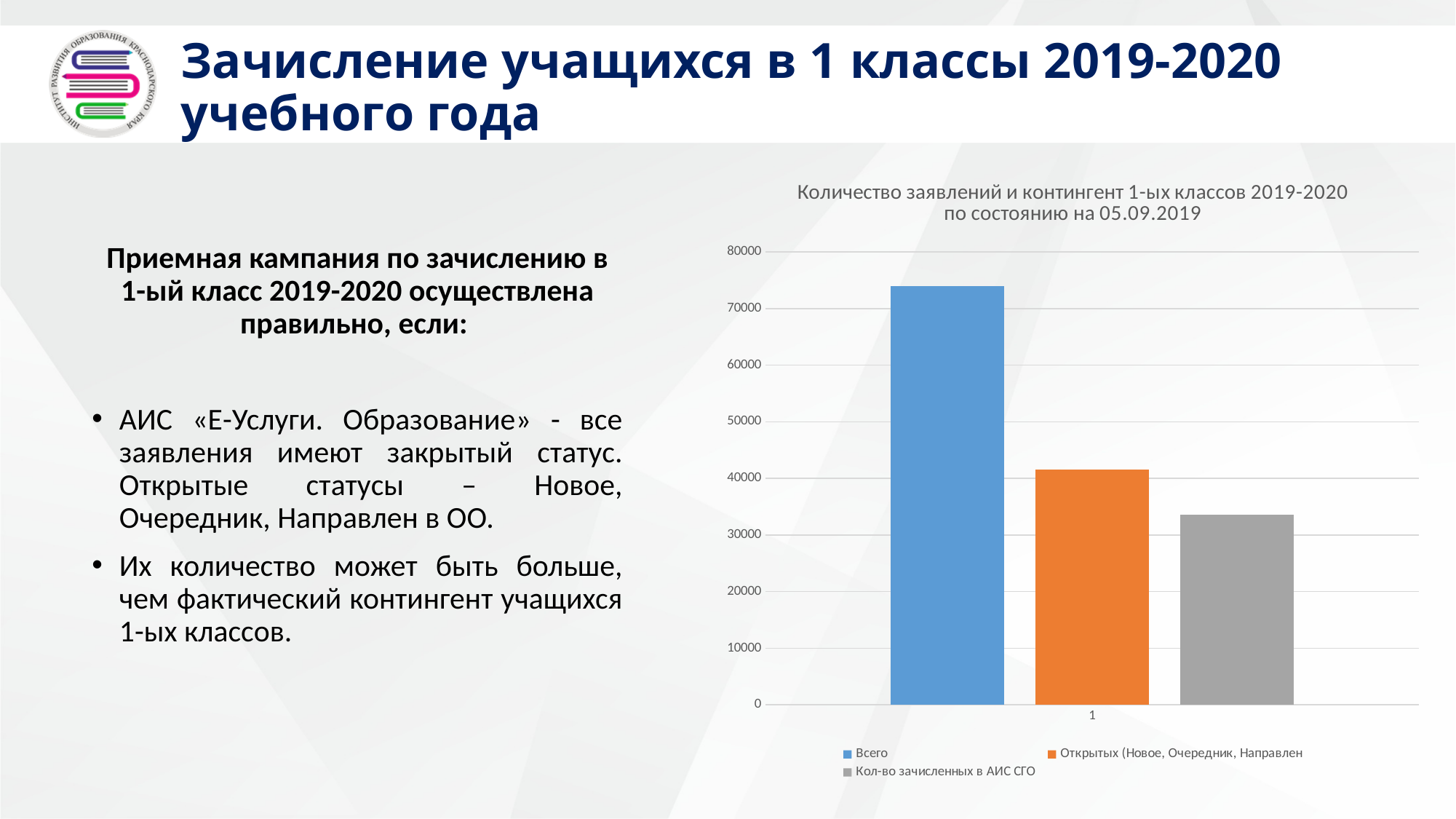
How many series does the chart legend list? 3 What is the title of the chart? Количество заявлений и контингент 1-ых классов 2019-2020 по состоянию на 05.09.2019 Is the value for Открытых (Новое, Очередник, Направлен) greater or less than 40000? greater Which is larger: the value for Всего or the value for Открытых (Новое, Очередник, Направлен)? Всего What kind of chart is shown on the slide? bar chart Is the value for Кол-во зачисленных в АИС СГО greater or less than 40000? less Which is larger: the value for Открытых (Новое, Очередник, Направлен) or the value for Кол-во зачисленных в АИС СГО? Открытых (Новое, Очередник, Направлен) Which series has the lowest value in the chart? Кол-во зачисленных в АИС СГО Is the value for Всего greater or less than 70000? greater What colour is the bar for Кол-во зачисленных в АИС СГО? grey Which series has the highest value in the chart? Всего